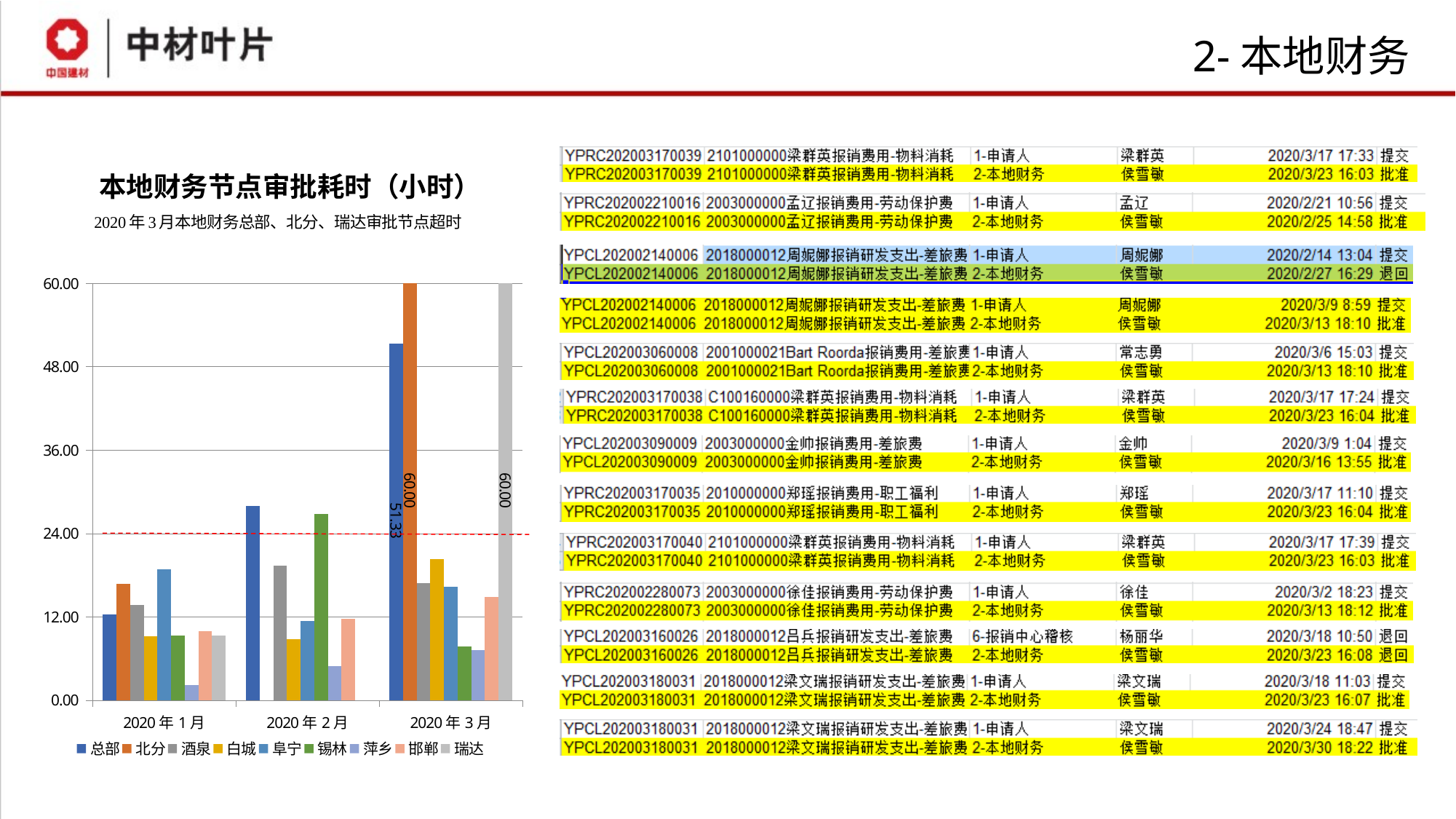
In 2020年3月, which is larger, the value for 总部 or the value for 北分? 北分 Is the value for 总部 in 2020年2月 greater or less than 24.00? greater Which series has the lowest value in 2020年1月? 萍乡 What is the title of the chart? 本地财务节点审批耗时（小时） What kind of chart is shown on the slide? bar chart What is the value for 瑞达 in 2020年3月? 60.00 Is the value for 萍乡 in 2020年1月 greater or less than 12.00? less What is the value for 北分 in 2020年3月? 60.00 How many series does the legend of the chart list? 9 How many month categories are shown on the x axis of the chart? 3 What is the value for 总部 in 2020年3月? 51.33 What is the difference between the values for 北分 and 总部 in 2020年3月? 8.67